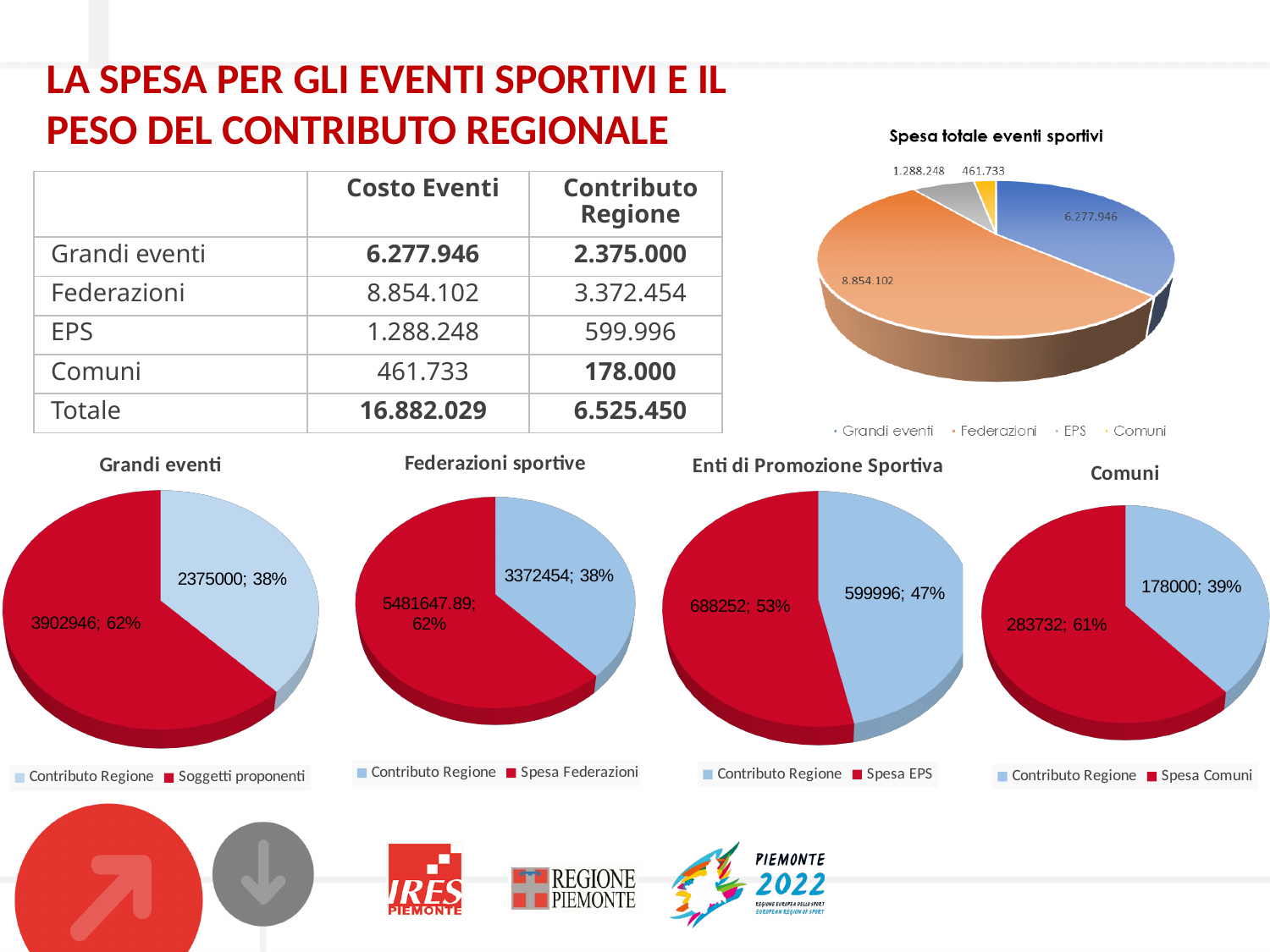
In the "Enti di Promozione Sportiva" chart, which is larger, Contributo Regione or Spesa EPS? Spesa EPS In the "Federazioni sportive" chart, what colour is the Spesa Federazioni slice? red How many categories does the legend of the "Spesa totale eventi sportivi" chart list? 4 In the "Grandi eventi" chart, what is the value for Soggetti proponenti? 3902946 In the "Spesa totale eventi sportivi" chart, what is the value for Federazioni? 8.854.102 In the "Grandi eventi" chart, what is the difference between Soggetti proponenti and Contributo Regione? 1527946 In the "Enti di Promozione Sportiva" chart, what share of the pie is Spesa EPS? 53% In the "Comuni" chart, what is the value for Contributo Regione? 178000 In the "Spesa totale eventi sportivi" chart, which category has the smallest slice? Comuni In the "Grandi eventi" chart, what share of the pie is Contributo Regione? 38% What kind of chart is "Spesa totale eventi sportivi"? pie chart In the "Spesa totale eventi sportivi" chart, which category has the largest slice? Federazioni